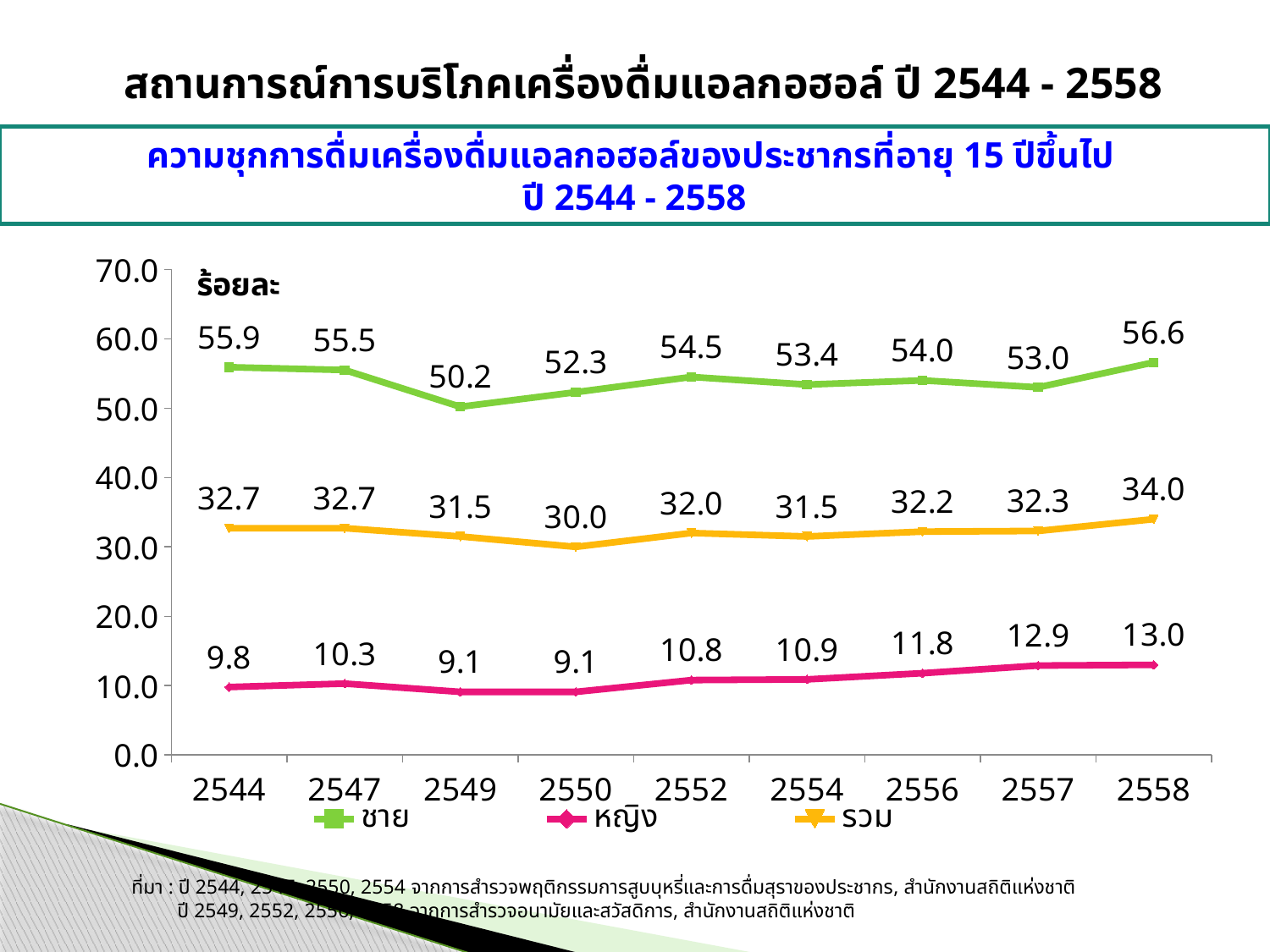
How many series does the legend list? 3 What is the value for ชาย (male) in 2558? 56.6 Which colour is used for the รวม (total) series? Orange What kind of chart is shown on the slide? Line chart In which year is the หญิง (female) series highest? 2558 What is the value for หญิง (female) in 2544? 9.8 Which is larger, the รวม (total) value in 2544 or in 2558? 2558 In which year is the ชาย (male) series lowest? 2549 Does the หญิง (female) series rise or fall from 2550 to 2558? Rise What is the difference between the ชาย (male) value in 2558 and in 2544? 0.7 How many years are shown on the x axis? 9 What is the value for รวม (total) in 2550? 30.0